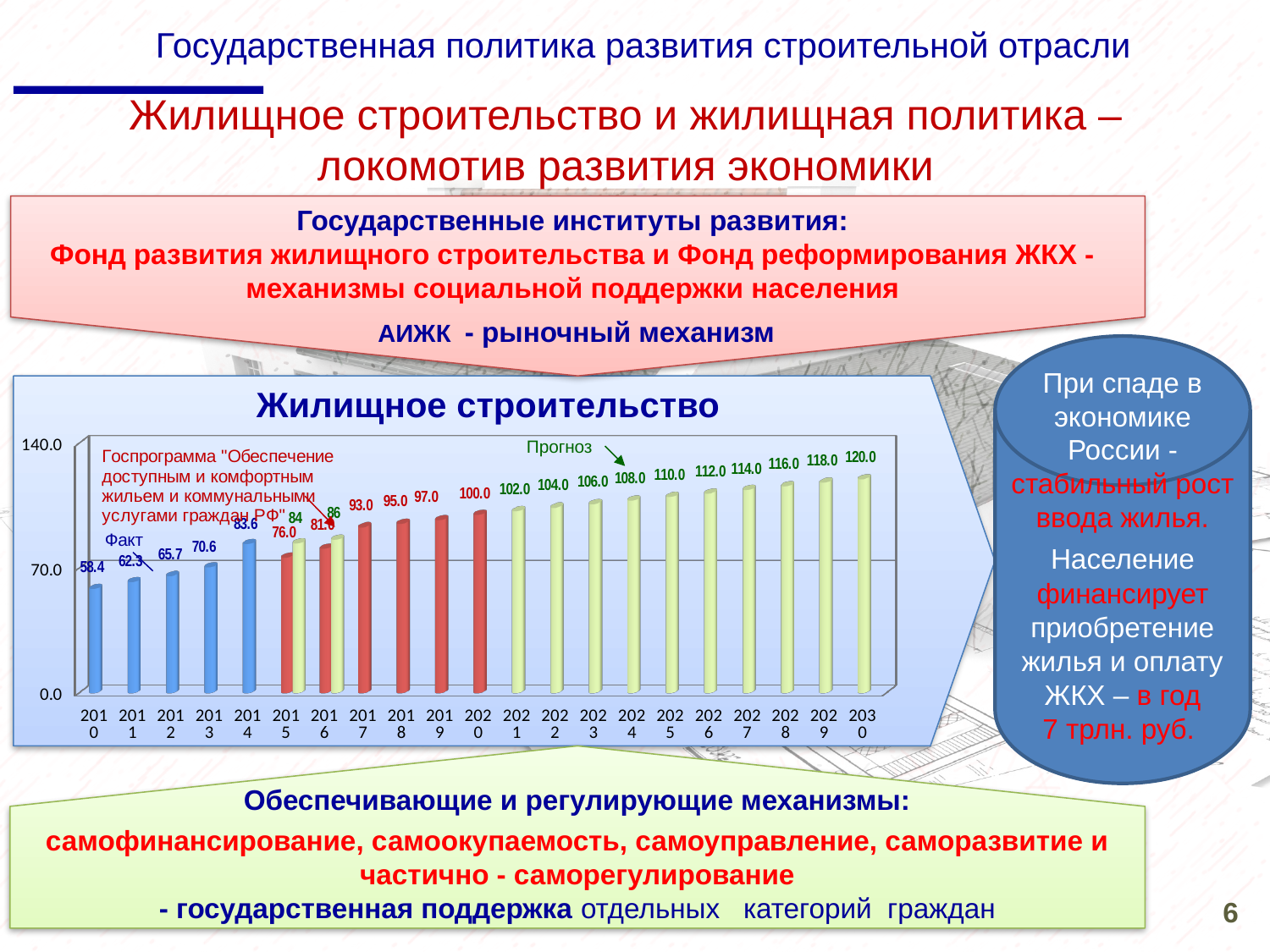
What is the value shown for 2020 in the Жилищное строительство chart? 100.0 What is the value shown for 2014 in the Жилищное строительство chart? 83.6 Which year has the lowest value in the Жилищное строительство chart? 2010 Is the value for 2025 in the Жилищное строительство chart greater or less than 70.0? greater Which is larger in the Жилищное строительство chart, the value for 2013 or the value for 2018? 2018 What kind of chart is the Жилищное строительство chart? bar chart Which year has the highest value in the Жилищное строительство chart? 2030 What is the difference between the values for 2030 and 2020 in the Жилищное строительство chart? 20.0 Do the values in the Жилищное строительство chart generally rise or fall from 2017 to 2030? rise What is the value shown for 2010 in the Жилищное строительство chart? 58.4 How many years are shown on the x axis of the Жилищное строительство chart? 21 What is the value shown for 2030 in the Жилищное строительство chart? 120.0